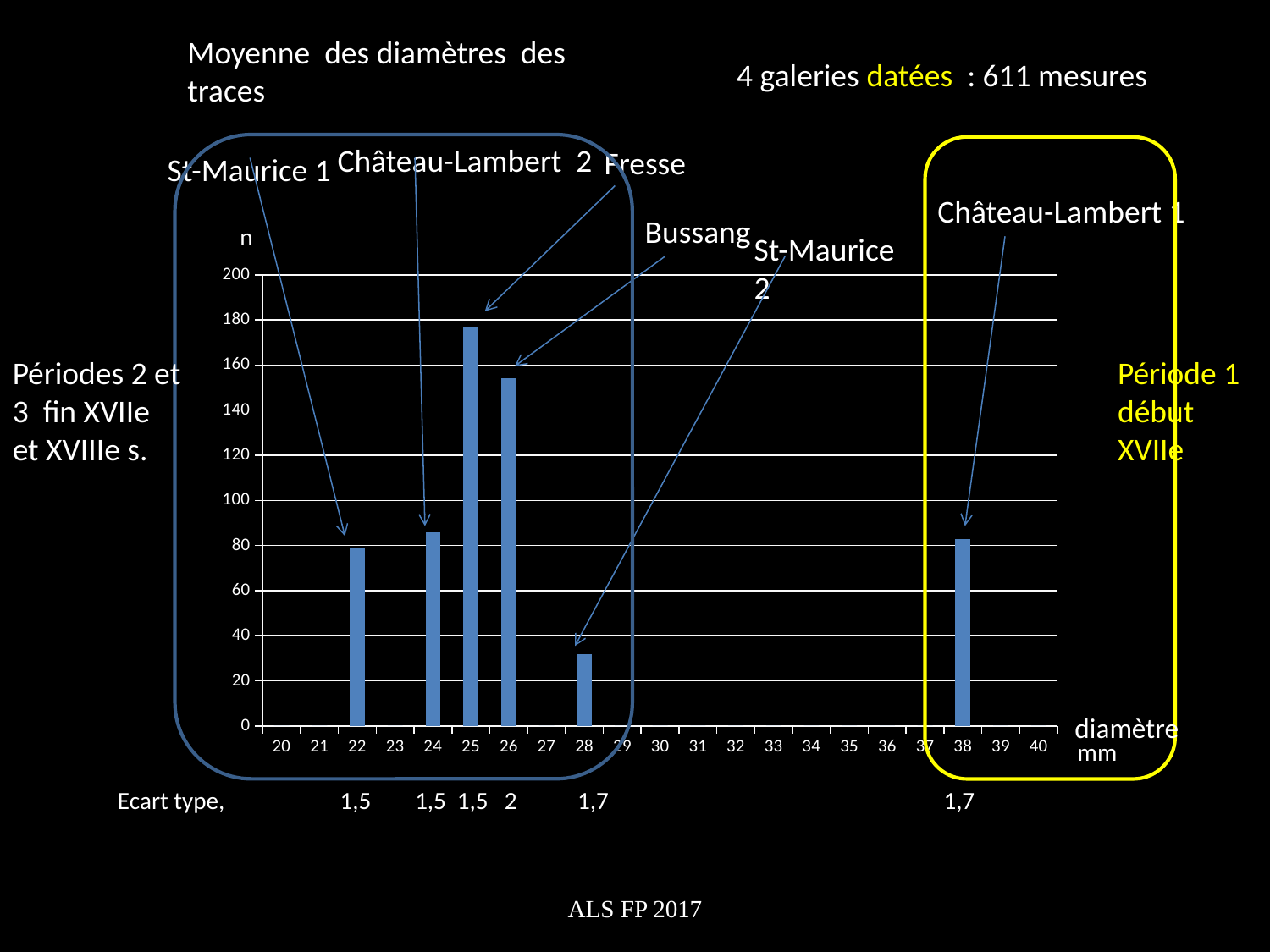
At which diameter (mm) is the tallest bar? 25 Is the value for 38 mm greater or less than 60? greater How many bars are plotted in the chart? 6 Is the value for 25 mm greater or less than 160? greater What is the label of the x axis of the chart? diamètre mm At which diameter (mm) is the shortest bar? 28 Is the value for 22 mm greater or less than 100? less Which bar is taller, the one at 24 mm or the one at 28 mm? 24 mm What kind of chart is shown on the slide? bar chart Which bar is taller, the one at 25 mm or the one at 26 mm? 25 mm